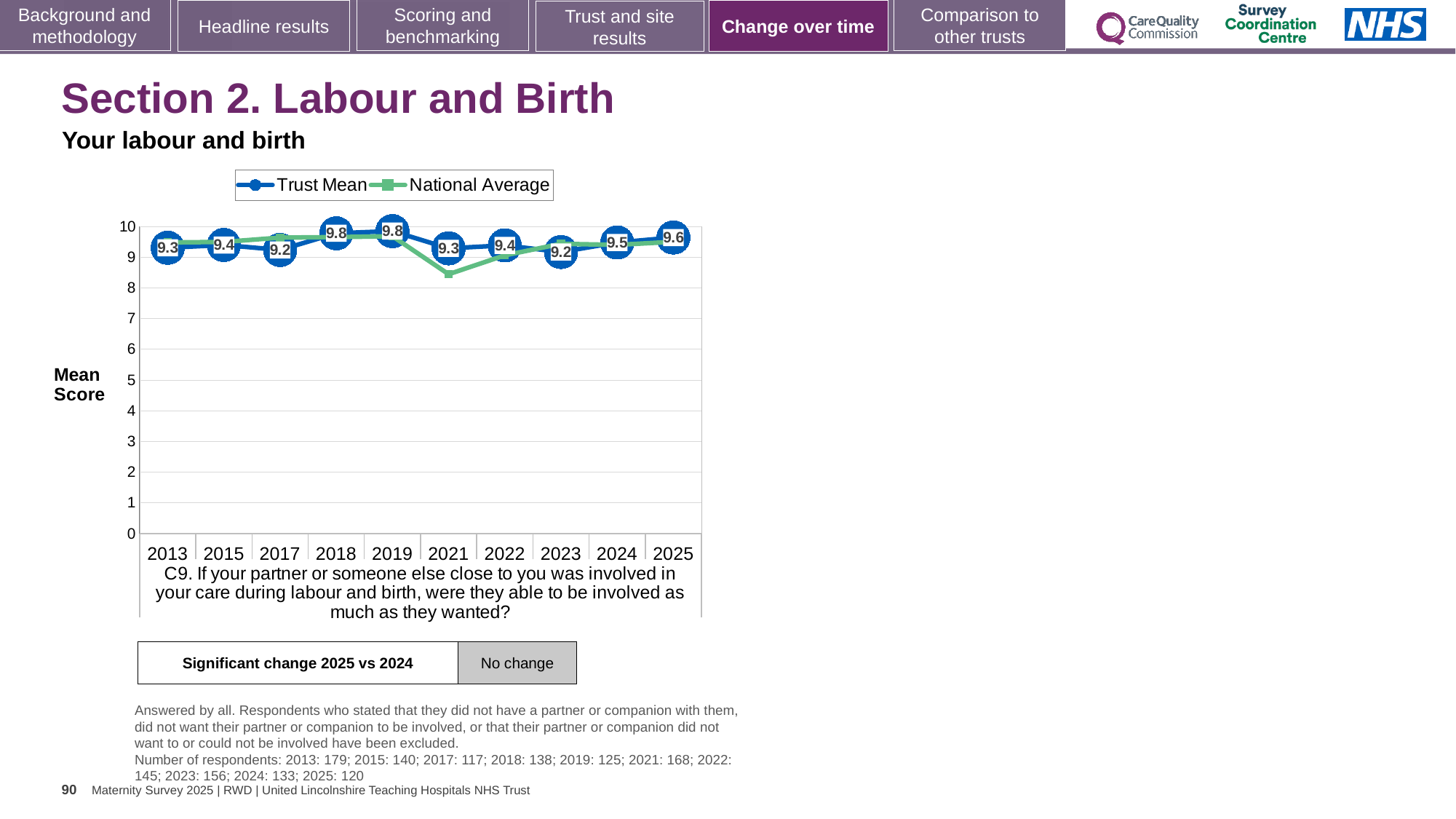
What is the Trust Mean for 2025? 9.6 What kind of chart is shown on the slide? line chart What is the lowest Trust Mean value shown on the chart? 9.2 What is the Trust Mean for 2018? 9.8 What is the difference between the Trust Mean for 2019 and the Trust Mean for 2021? 0.5 How many years are shown on the x axis of the chart? 10 Does the Trust Mean rise or fall from 2023 to 2025? rise Which year has the larger Trust Mean, 2017 or 2018? 2018 Is the National Average for 2021 greater or less than 9? less What is the Trust Mean for 2021? 9.3 What is the highest Trust Mean value shown on the chart? 9.8 How many series does the chart legend list? 2